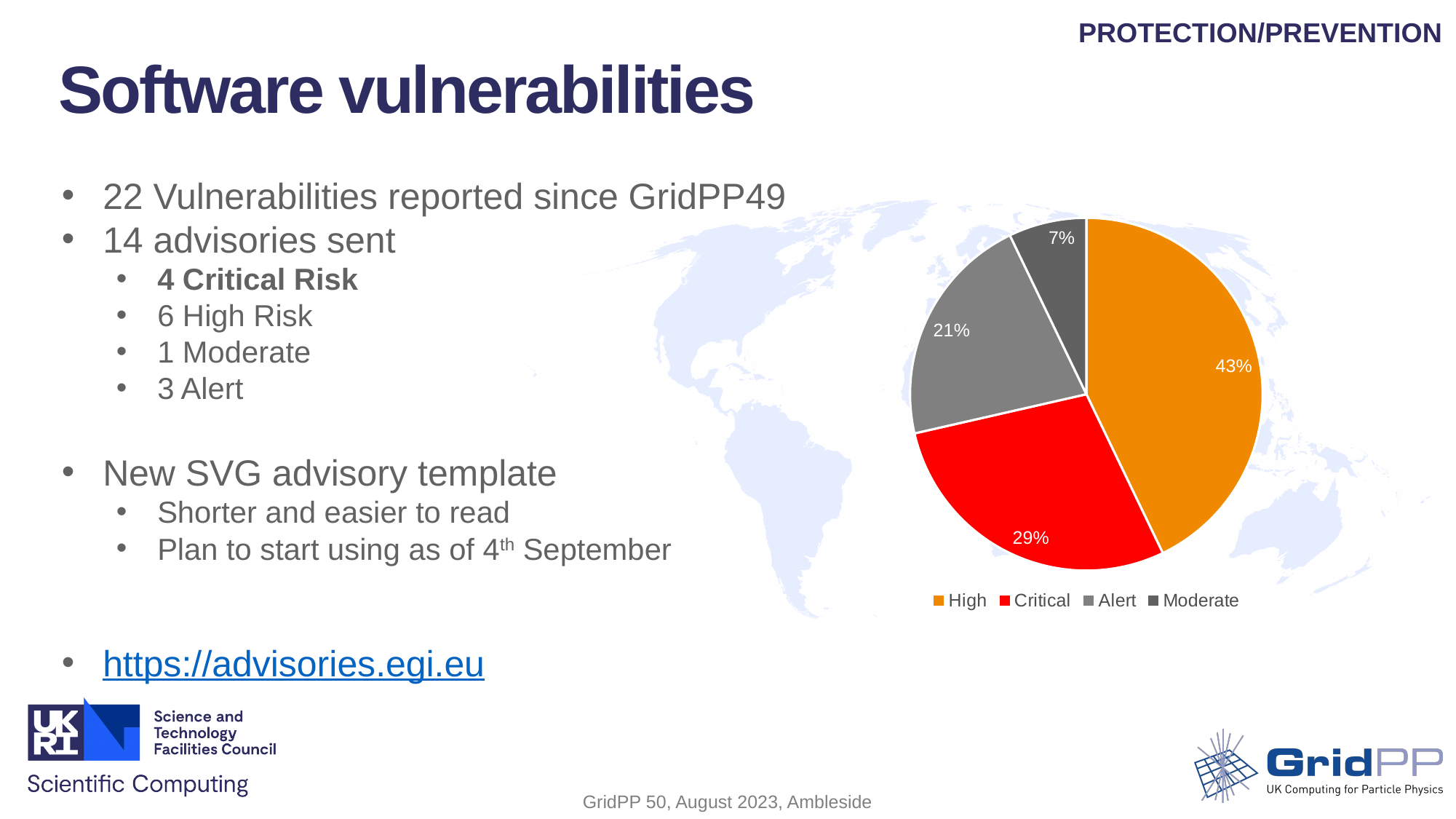
What percentage of the pie chart is the High slice? 43% What kind of chart is shown on the slide? pie chart Which category is shown in orange in the pie chart? High Which category has the largest slice in the pie chart? High Which category has the smallest slice in the pie chart? Moderate What percentage of the pie chart is the Critical slice? 29% What percentage of the pie chart is the Moderate slice? 7% What is the difference in percentage points between the High and Critical slices? 14 What colour is the Critical slice in the pie chart? red Which slice is larger, Alert or Critical? Critical How many categories does the pie chart show? 4 What percentage of the pie chart is the Alert slice? 21%